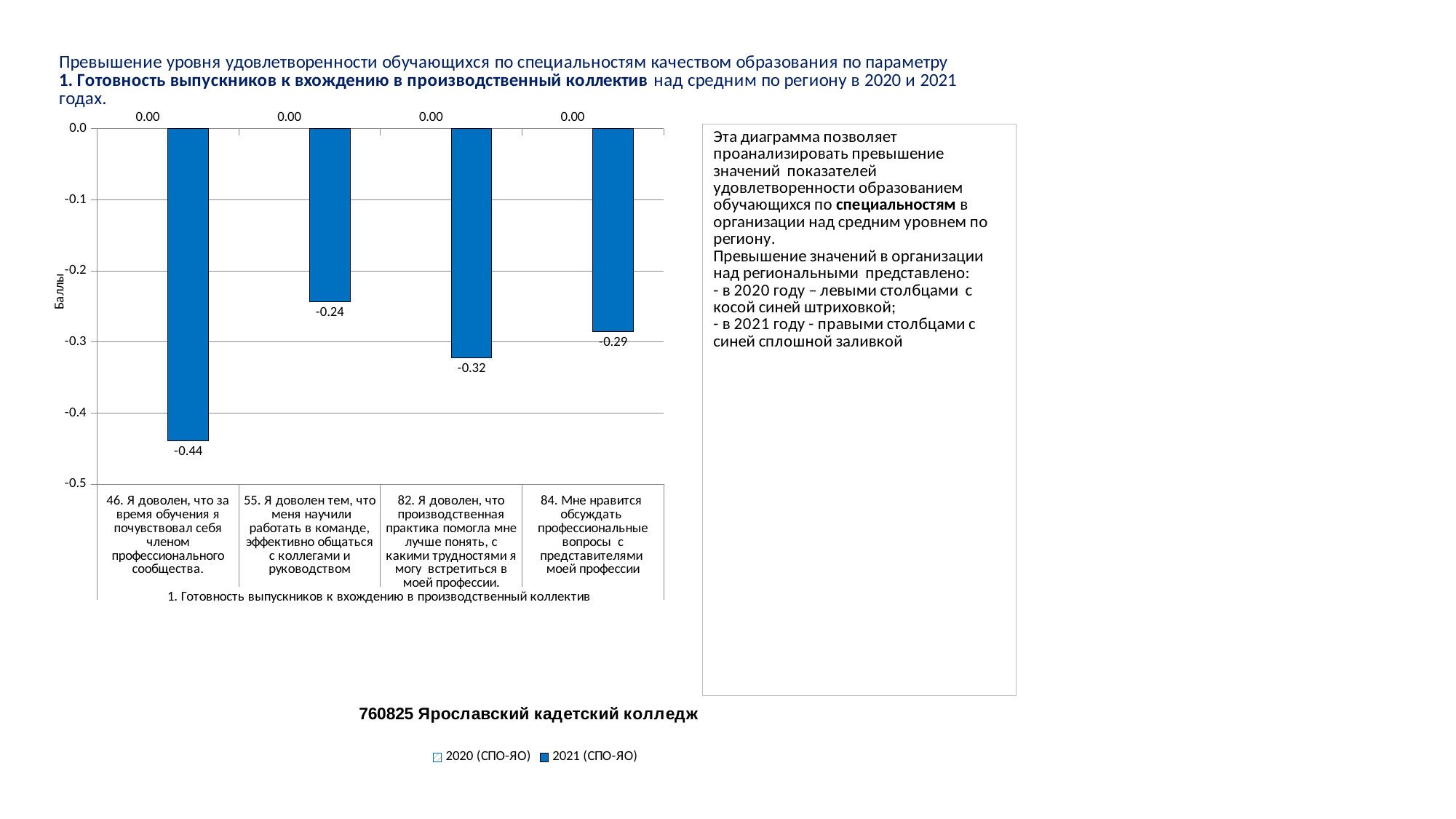
What is the 2021 (СПО-ЯО) value for category 46 (Я доволен, что за время обучения я почувствовал себя членом профессионального сообщества)? -0.44 What is the 2021 (СПО-ЯО) value for category 84 (Мне нравится обсуждать профессиональные вопросы с представителями моей профессии)? -0.29 Which is larger, the 2021 value for category 82 or for category 84? 84. Мне нравится обсуждать профессиональные вопросы с представителями моей профессии Which category has the highest 2021 (СПО-ЯО) value? 55. Я доволен тем, что меня научили работать в команде, эффективно общаться с коллегами и руководством How many categories are shown on the x axis of the chart? 4 How many series does the legend list? 2 What is the difference between the 2021 values for category 46 and category 55? 0.20 What is the 2020 (СПО-ЯО) value for category 46? 0.00 What is the 2021 (СПО-ЯО) value for category 55 (Я доволен тем, что меня научили работать в команде)? -0.24 Which category has the lowest 2021 (СПО-ЯО) value? 46. Я доволен, что за время обучения я почувствовал себя членом профессионального сообщества. What type of chart is shown on the slide? Bar chart What is the 2021 (СПО-ЯО) value for category 82 (Я доволен, что производственная практика помогла мне лучше понять...)? -0.32